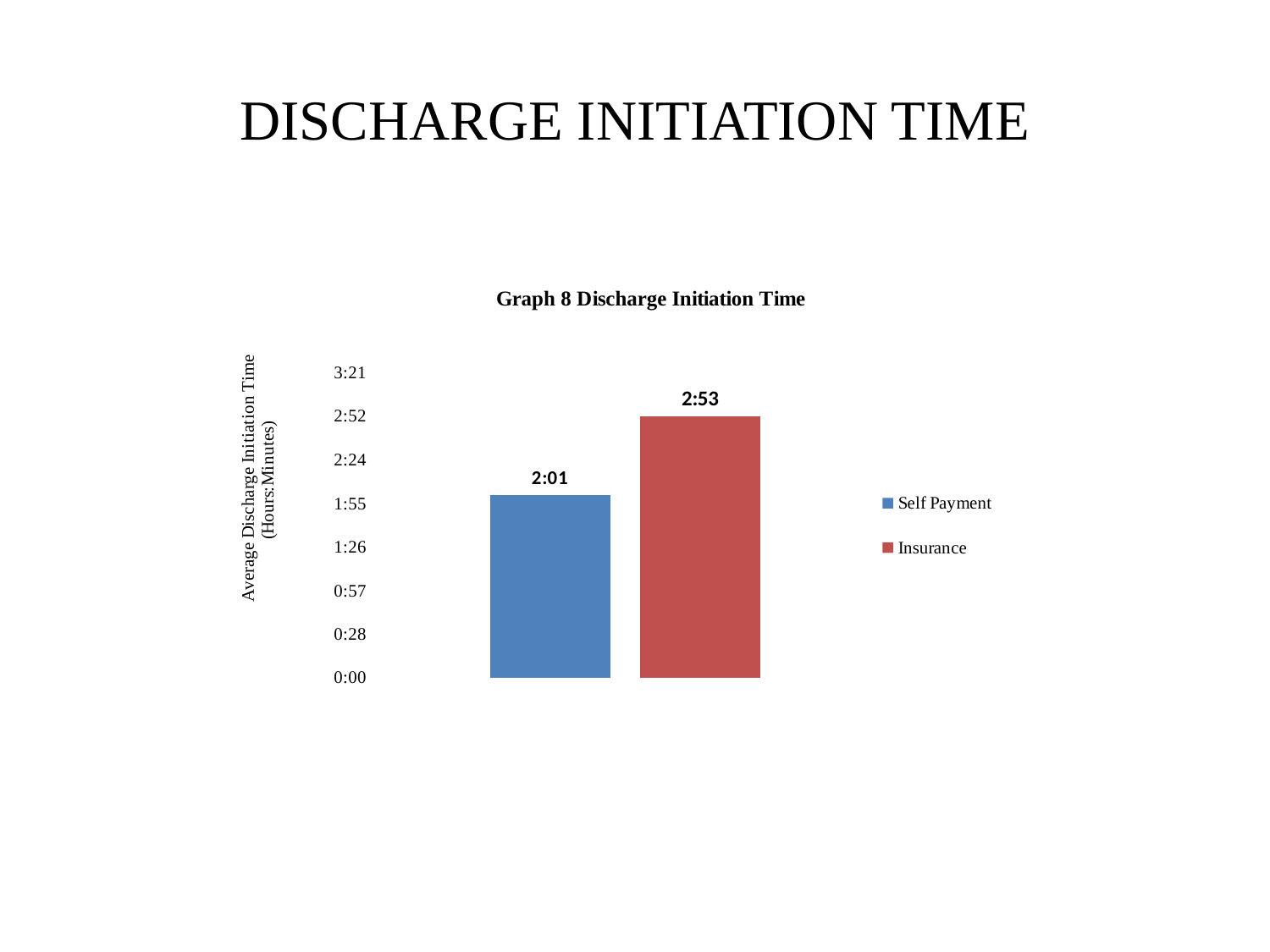
Is the value for Insurance greater or less than 2:24? greater Which series has the lowest average discharge initiation time? Self Payment How many series does the legend list? 2 Which is larger, the discharge initiation time for Self Payment or for Insurance? Insurance What is the title of the chart? Graph 8 Discharge Initiation Time What is the average discharge initiation time for Insurance? 2:53 What is the average discharge initiation time for Self Payment? 2:01 Which series has the highest average discharge initiation time? Insurance What kind of chart is shown on the slide? bar chart Is the value for Self Payment greater or less than 2:24? less What colour is the Insurance bar? red What is the difference between the Insurance and Self Payment discharge initiation times? 0:52